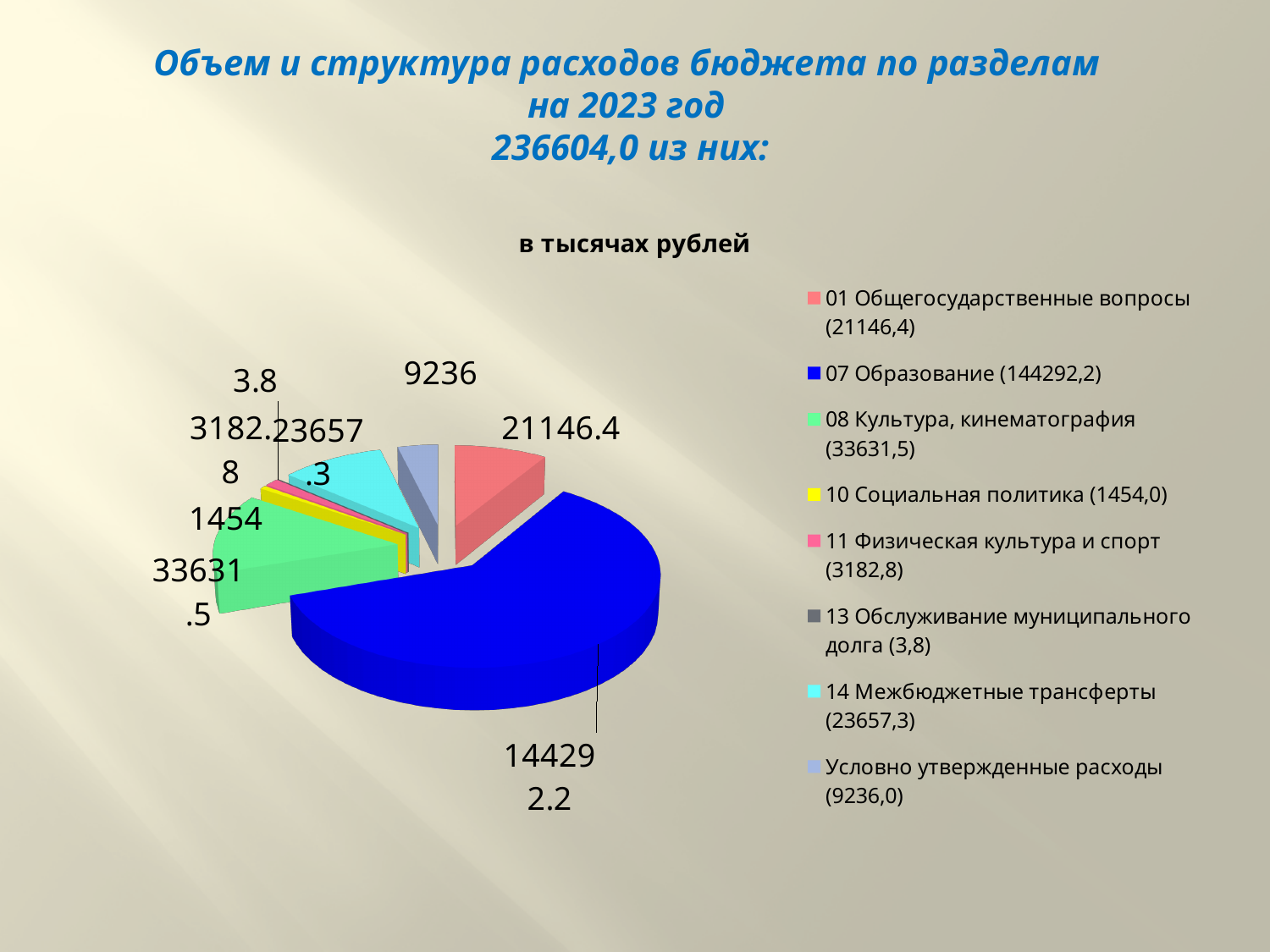
How many entries does the legend list? 8 What is the value for 08 Культура, кинематография? 33631.5 What is the value for 07 Образование? 144292.2 What type of chart is shown on the slide? pie chart What is the value for Условно утвержденные расходы? 9236 Which category has the largest slice of the pie? 07 Образование What unit is stated in the chart title? в тысячах рублей What is the value for 14 Межбюджетные трансферты? 23657.3 How many categories does the pie chart have? 8 What is the difference between 08 Культура, кинематография and 14 Межбюджетные трансферты? 9974.2 Which category has the smallest slice of the pie? 13 Обслуживание муниципального долга Which is larger: 01 Общегосударственные вопросы or 14 Межбюджетные трансферты? 14 Межбюджетные трансферты